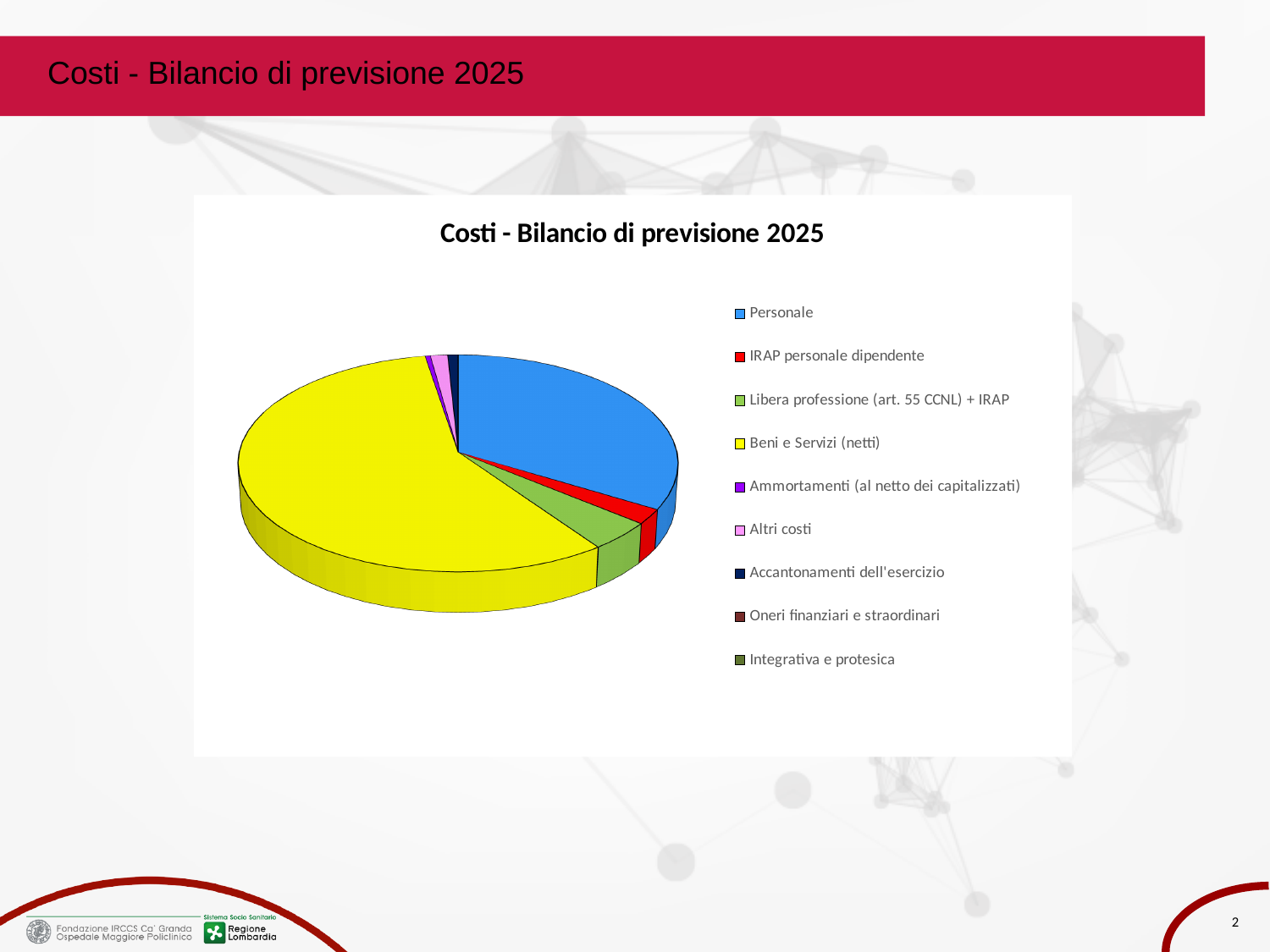
Which slice is larger: Personale or IRAP personale dipendente? Personale What is the title of the chart? Costi - Bilancio di previsione 2025 Which slice is larger: Libera professione (art. 55 CCNL) + IRAP or Altri costi? Libera professione (art. 55 CCNL) + IRAP Which category has the second-largest slice of the pie? Personale Which slice is larger: Personale or Libera professione (art. 55 CCNL) + IRAP? Personale Which category has the largest slice of the pie? Beni e Servizi (netti) Which category is shown in yellow in the pie chart? Beni e Servizi (netti) What kind of chart is shown on the slide? pie chart How many categories does the legend of the pie chart list? 9